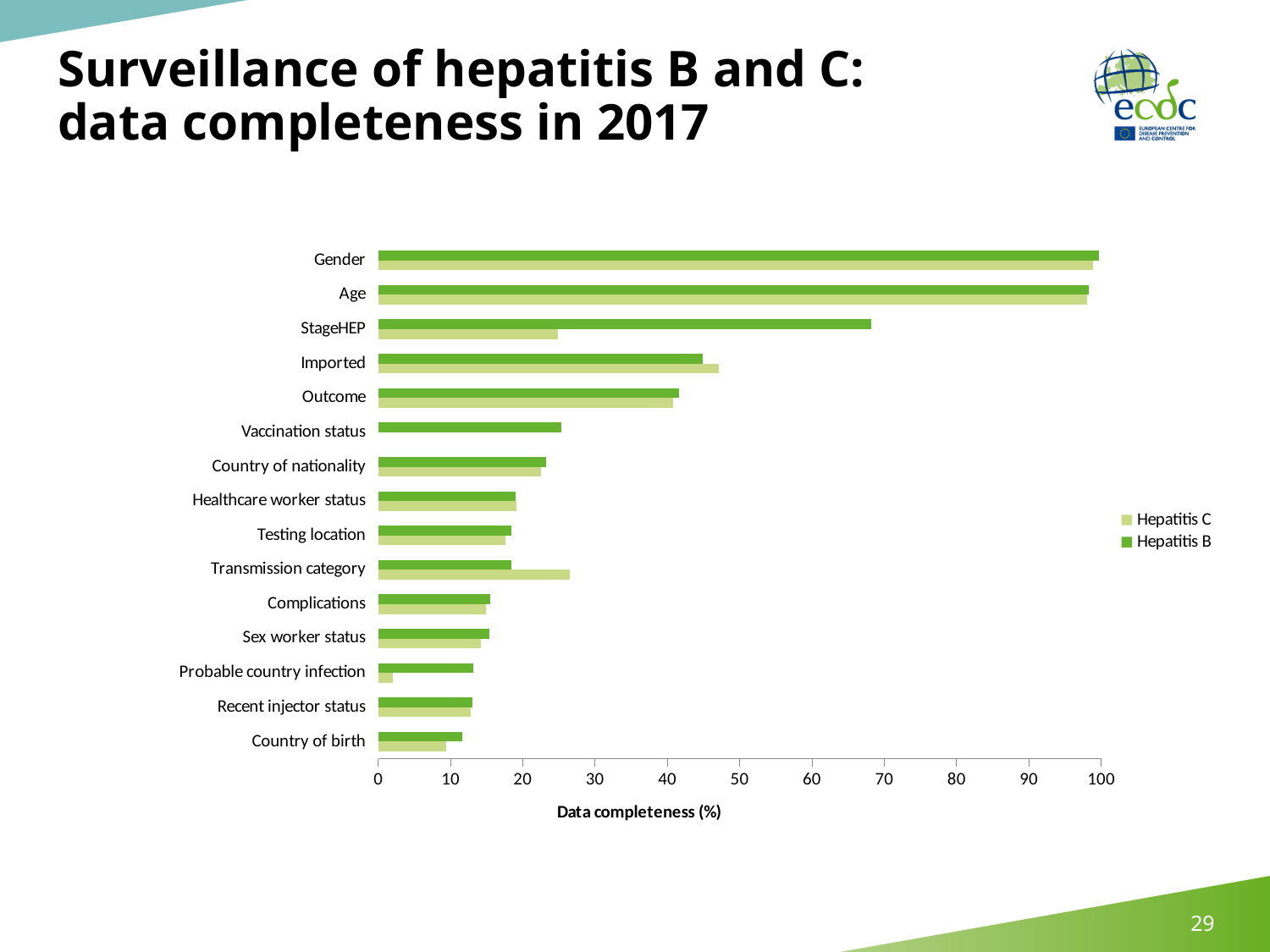
Is the Hepatitis C value for Probable country infection greater or less than 10? less For StageHEP, which series has the larger value, Hepatitis B or Hepatitis C? Hepatitis B What kind of chart is shown on the slide? Bar chart What is the title of the horizontal axis of the chart? Data completeness (%) For Transmission category, which series has the larger value, Hepatitis B or Hepatitis C? Hepatitis C Is the Hepatitis C value for StageHEP greater or less than 30? less How many series does the legend list? 2 Which category has the lowest Hepatitis C value? Probable country infection Which category has the lowest Hepatitis B value? Country of birth How many categories are shown on the vertical axis of the chart? 15 Is the Hepatitis C value for Imported greater or less than 40? greater